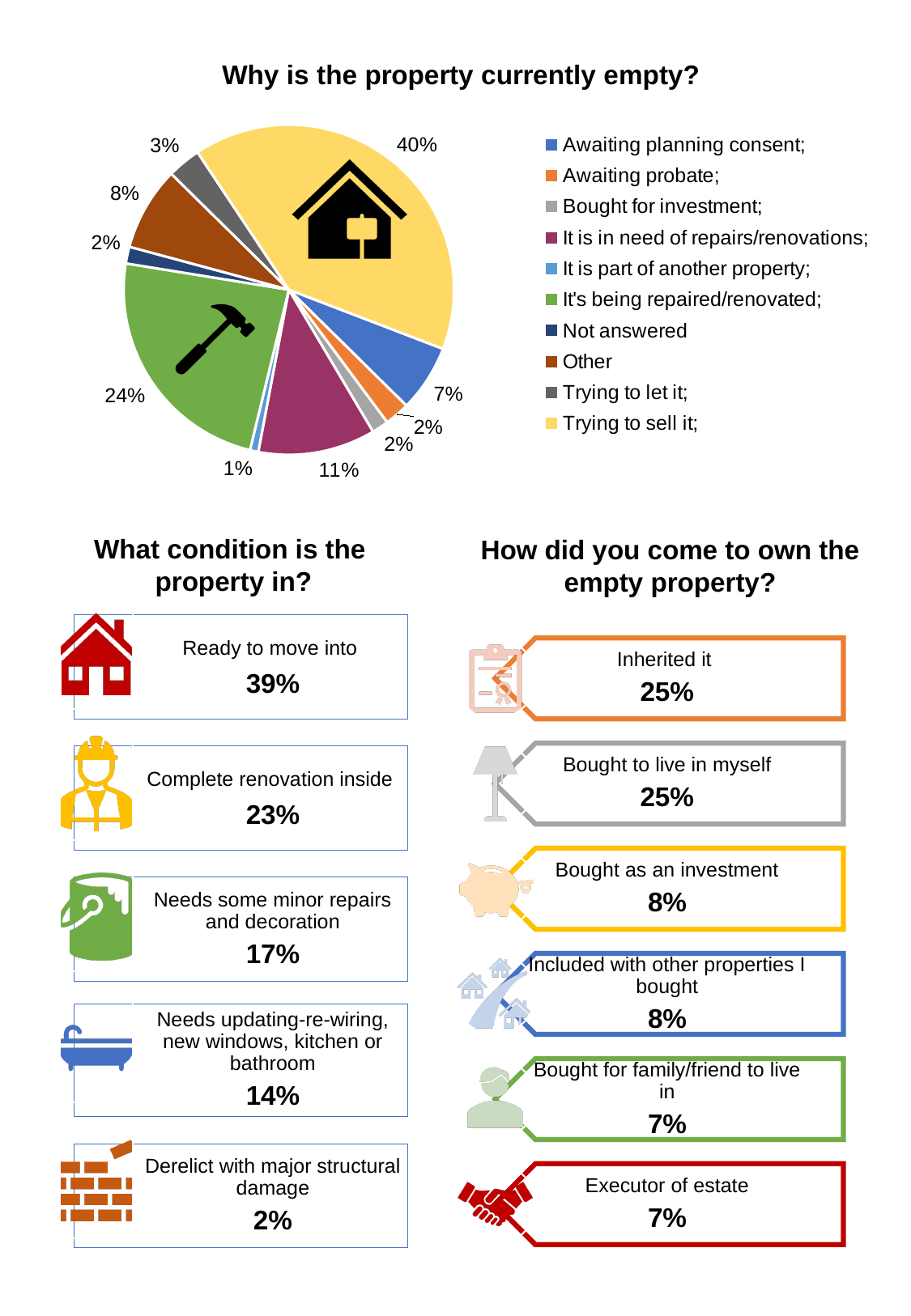
In the 'Why is the property currently empty?' pie chart, which is larger: 'Awaiting planning consent' or 'Other'? Other In the 'Why is the property currently empty?' pie chart, which category has the largest slice? Trying to sell it In the 'Why is the property currently empty?' pie chart, what share is 'Trying to let it'? 3% In the 'Why is the property currently empty?' pie chart, what share is 'It's being repaired/renovated'? 24% What kind of chart is used for 'Why is the property currently empty?' pie chart In the 'Why is the property currently empty?' pie chart, what colour is the 'Trying to sell it' slice? yellow In the 'Why is the property currently empty?' pie chart, how many percentage points larger is 'Trying to sell it' than 'It's being repaired/renovated'? 16 In the 'What condition is the property in?' section, what percentage is 'Ready to move into'? 39% In the 'Why is the property currently empty?' pie chart, what share is 'Trying to sell it'? 40% In the 'Why is the property currently empty?' pie chart, what share is 'It is in need of repairs/renovations'? 11% How many categories does the legend of the 'Why is the property currently empty?' pie chart list? 10 In the 'Why is the property currently empty?' pie chart, which category has the smallest slice? It is part of another property